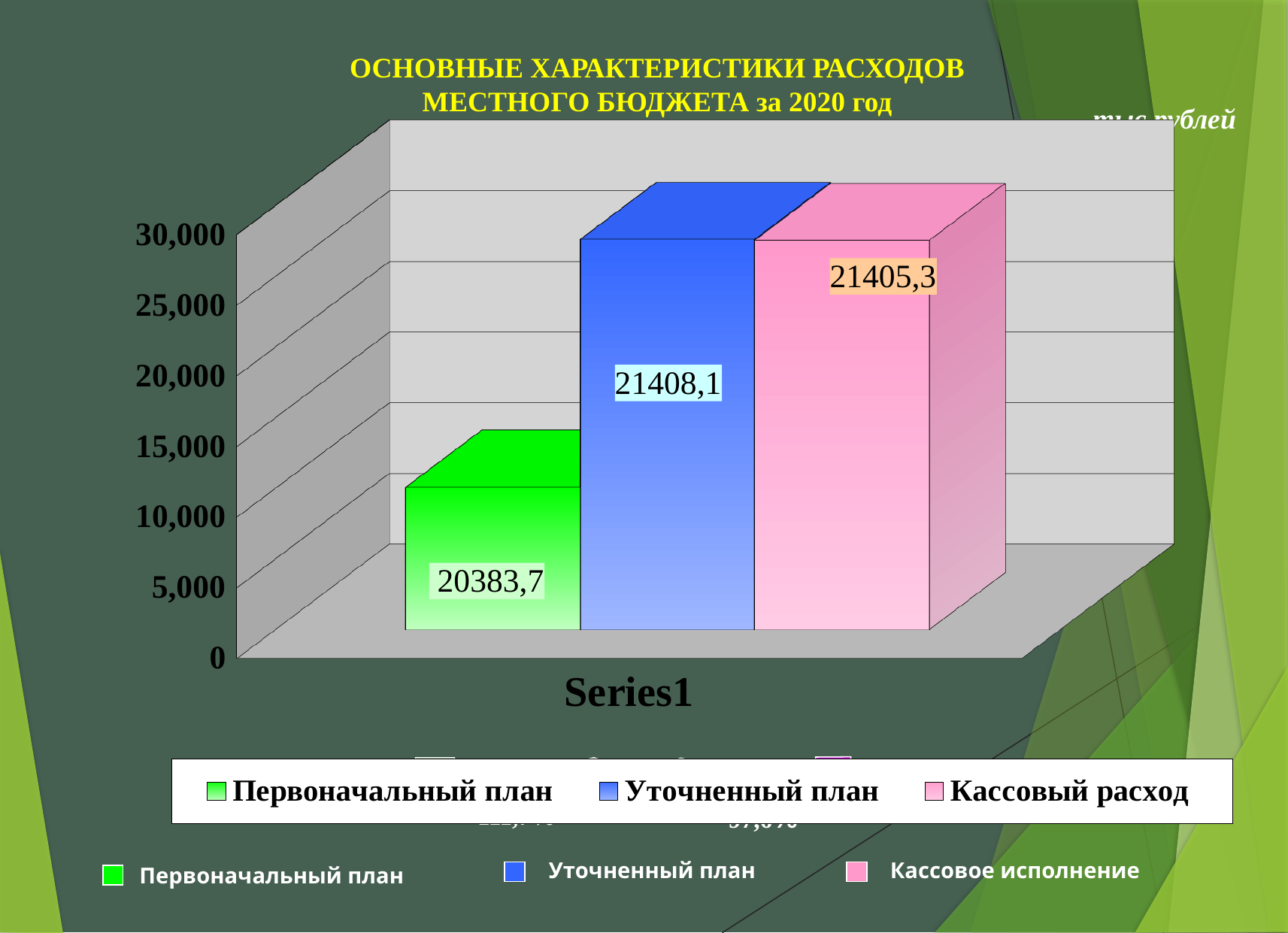
What is the value for Кассовый расход? 21405,3 What unit is indicated for the values in the chart? тыс.рублей How many series does the legend list? 3 Which is larger, Первоначальный план or Кассовый расход? Кассовый расход What is the value for Уточненный план? 21408,1 Which series has the highest value according to the data labels? Уточненный план What is the value for Первоначальный план? 20383,7 What is the difference between Кассовый расход and Первоначальный план? 1021,6 Which series has the lowest value? Первоначальный план Is the value for Первоначальный план greater or less than 10,000? greater What kind of chart is shown on the slide? bar chart What is the difference between Уточненный план and Первоначальный план? 1024,4